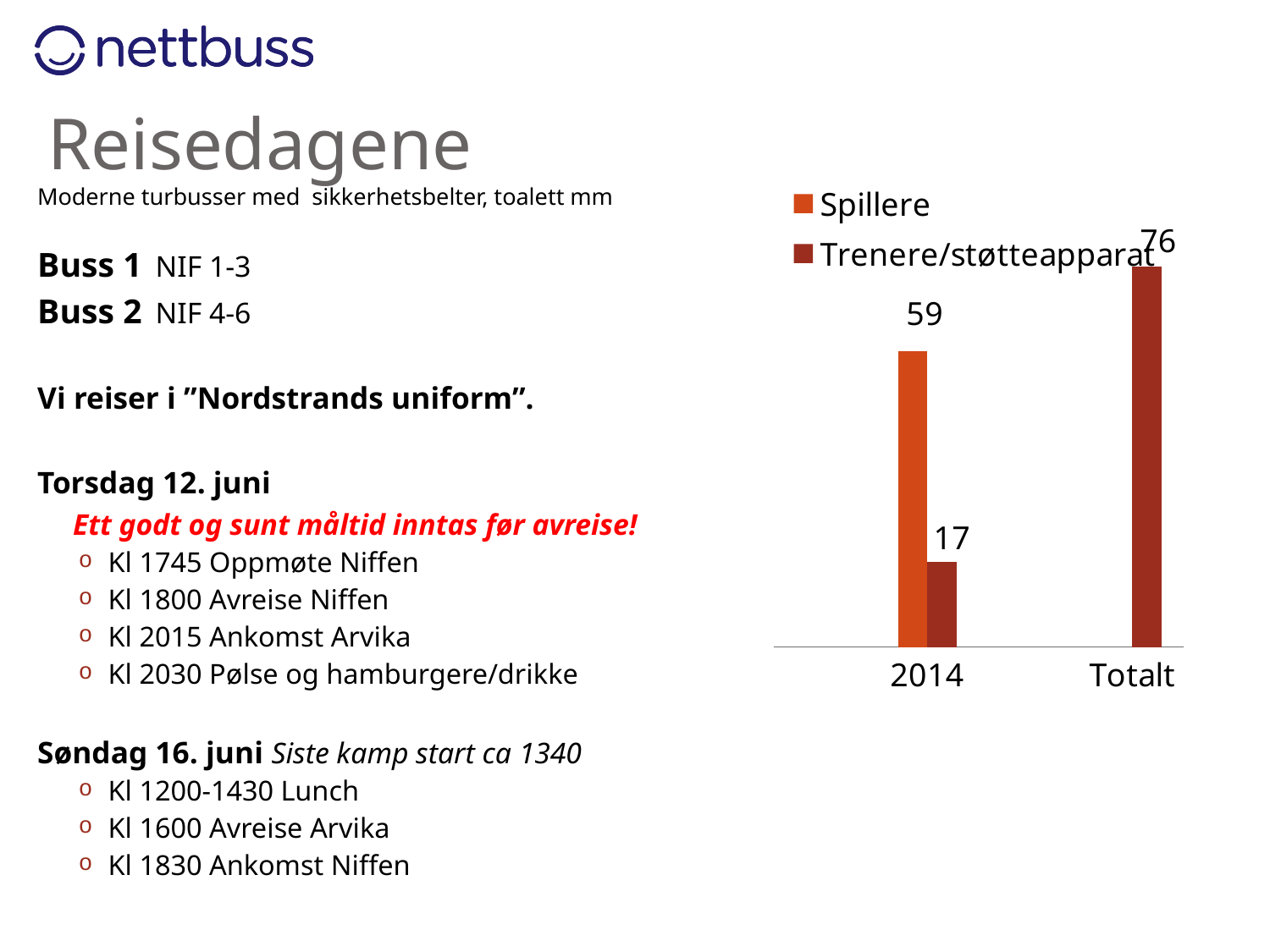
What is the difference between the Spillere and Trenere/støtteapparat values for 2014? 42 What is the value of Trenere/støtteapparat for 2014? 17 How many categories are shown on the x axis of the chart? 2 What kind of chart is shown on the slide? Bar chart What is the value of Spillere for 2014? 59 How many series does the chart legend list? 2 What value is shown on the bar for Totalt? 76 For 2014, which is larger: Spillere or Trenere/støtteapparat? Spillere Which bar in the chart has the highest value? Totalt (76) Which bar in the chart has the lowest value? Trenere/støtteapparat for 2014 (17) What is the difference between the Totalt bar and the Spillere value for 2014? 17 What are the two entries in the chart legend? Spillere and Trenere/støtteapparat